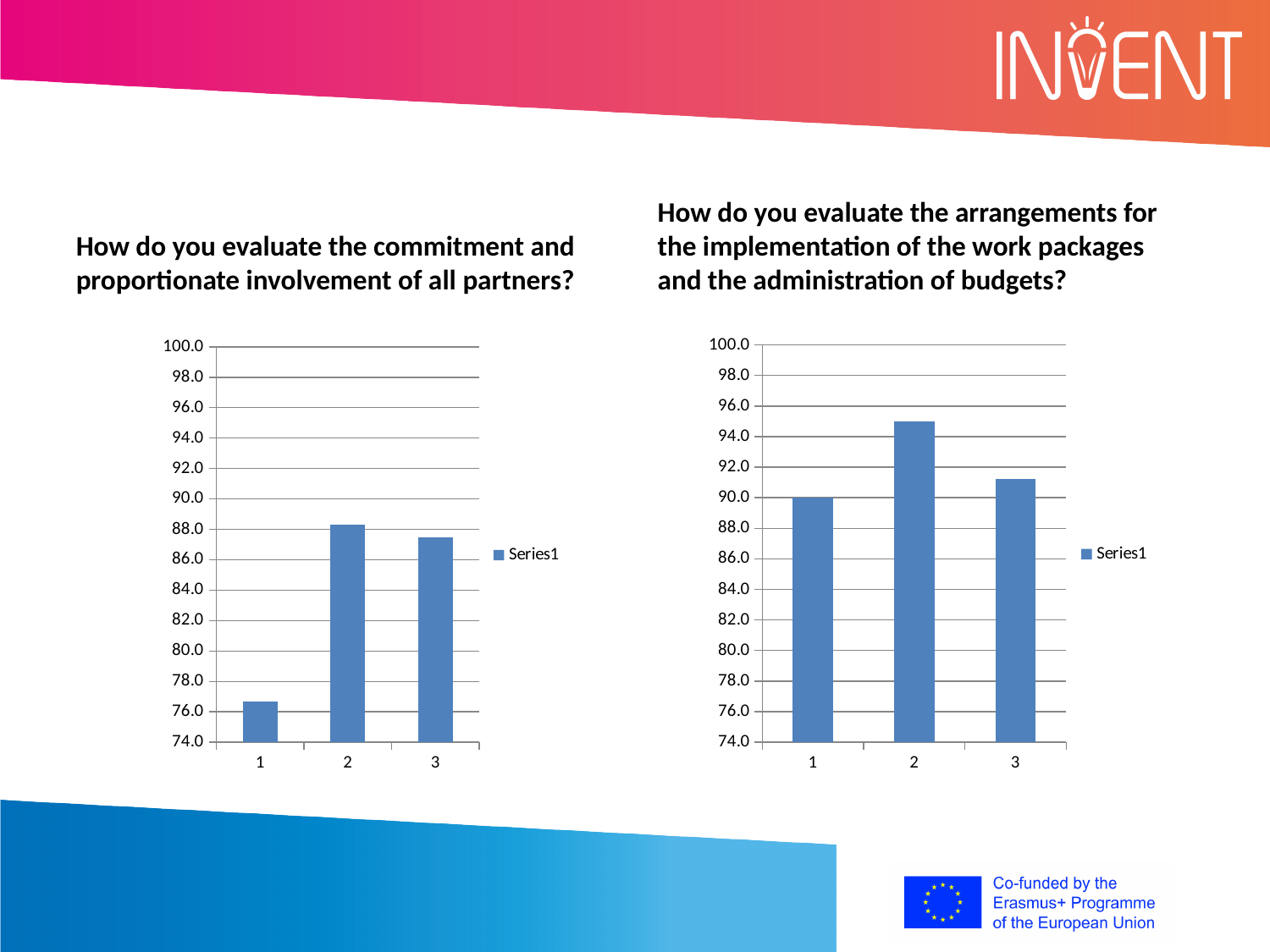
What kind of chart is shown under the title 'How do you evaluate the commitment and proportionate involvement of all partners?'? bar chart In the left chart (commitment and proportionate involvement of all partners), is the value for category 1 greater or less than 78.0? less In the right chart (arrangements for the implementation of the work packages and the administration of budgets), is the value for category 3 greater or less than 90.0? greater In the left chart (commitment and proportionate involvement of all partners), how many categories are shown on the x axis? 3 In the right chart (arrangements for the implementation of the work packages and the administration of budgets), which category has the highest value? 2 How many series does the legend of the right chart list? 1 In the left chart (commitment and proportionate involvement of all partners), which is larger, the value for category 1 or category 3? 3 In the left chart (commitment and proportionate involvement of all partners), which category has the lowest value? 1 In the left chart (commitment and proportionate involvement of all partners), is the value for category 2 greater or less than 86.0? greater In the right chart (arrangements for the implementation of the work packages and the administration of budgets), what is the value for category 1? 90.0